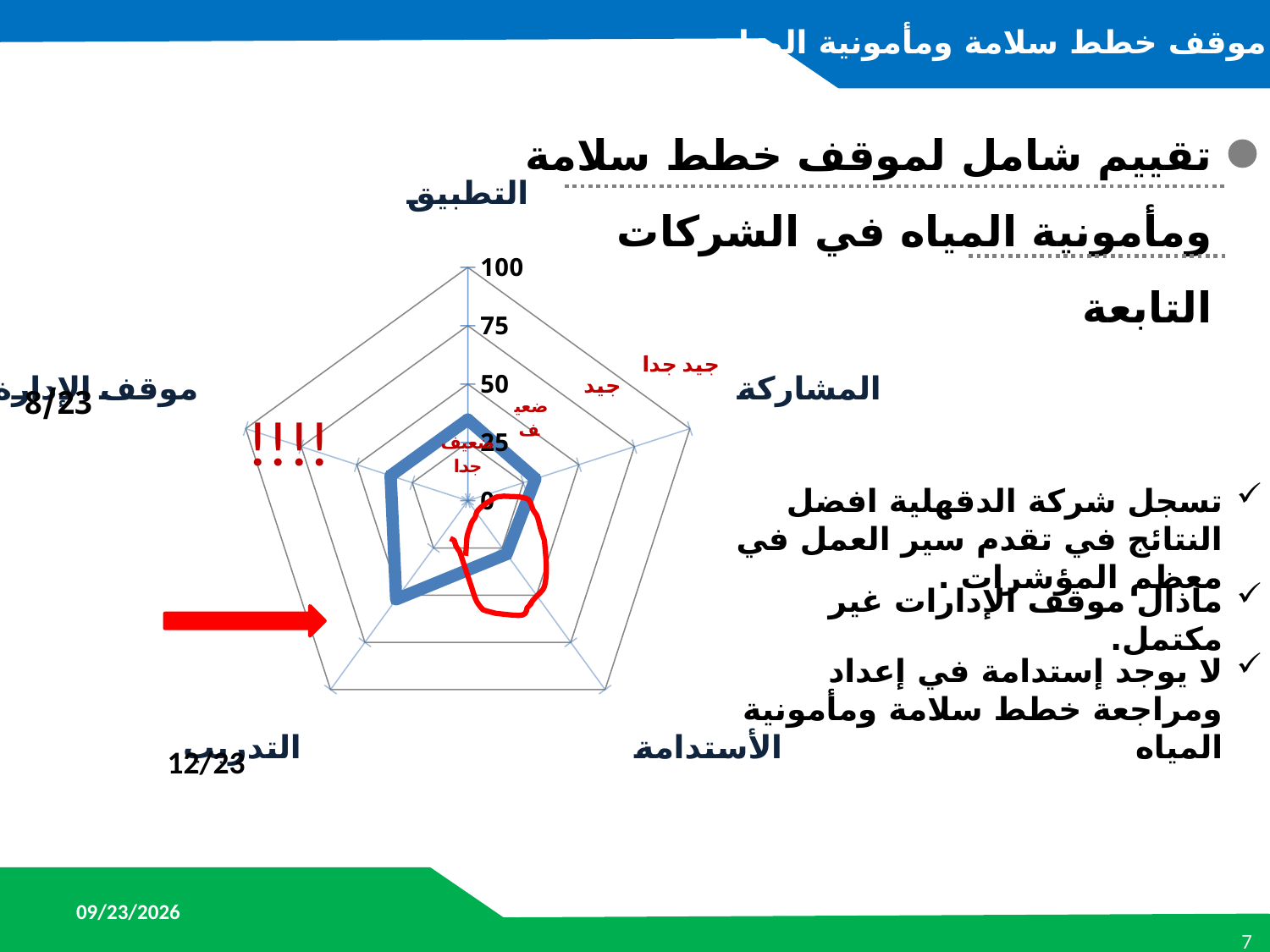
Is the value for التدريب greater or less than 25? greater How many axes (categories) does the radar chart have? 5 Which category has the highest value on the radar chart? التدريب Is the value for التطبيق greater or less than 25? greater Is the value for التطبيق greater or less than 75? less What is the highest value shown on the radar chart's axis scale? 100 Which category is labelled at the top of the radar chart? التطبيق What kind of chart is shown on the slide? Radar chart Which is larger, the value for التدريب or the value for الأستدامة? التدريب